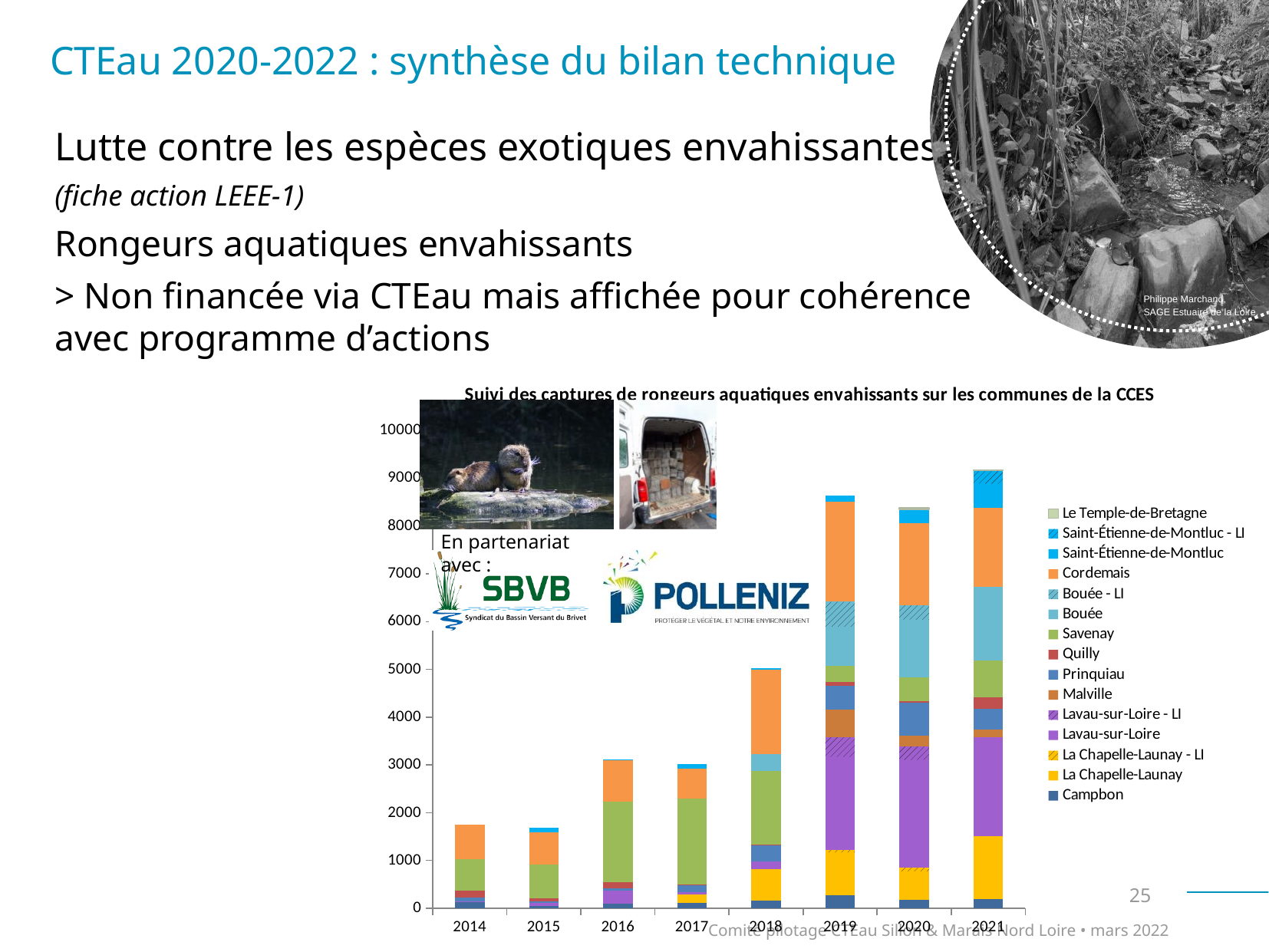
Which year has the larger total bar, 2018 or 2021? 2021 How many series does the chart legend list? 15 How many years are shown along the x axis of the chart? 8 What is the title of the chart? Suivi des captures de rongeurs aquatiques envahissants sur les communes de la CCES What type of chart is shown on the slide? Stacked bar chart Is the total for 2018 greater or less than 6000? less Is the total for 2019 greater or less than 8000? greater Which year has the highest total bar in the chart? 2021 Is the total for 2016 greater or less than 2000? greater Do the total captures generally rise or fall from 2014 to 2021? rise Which legend entry is listed first (at the top) in the chart legend? Le Temple-de-Bretagne